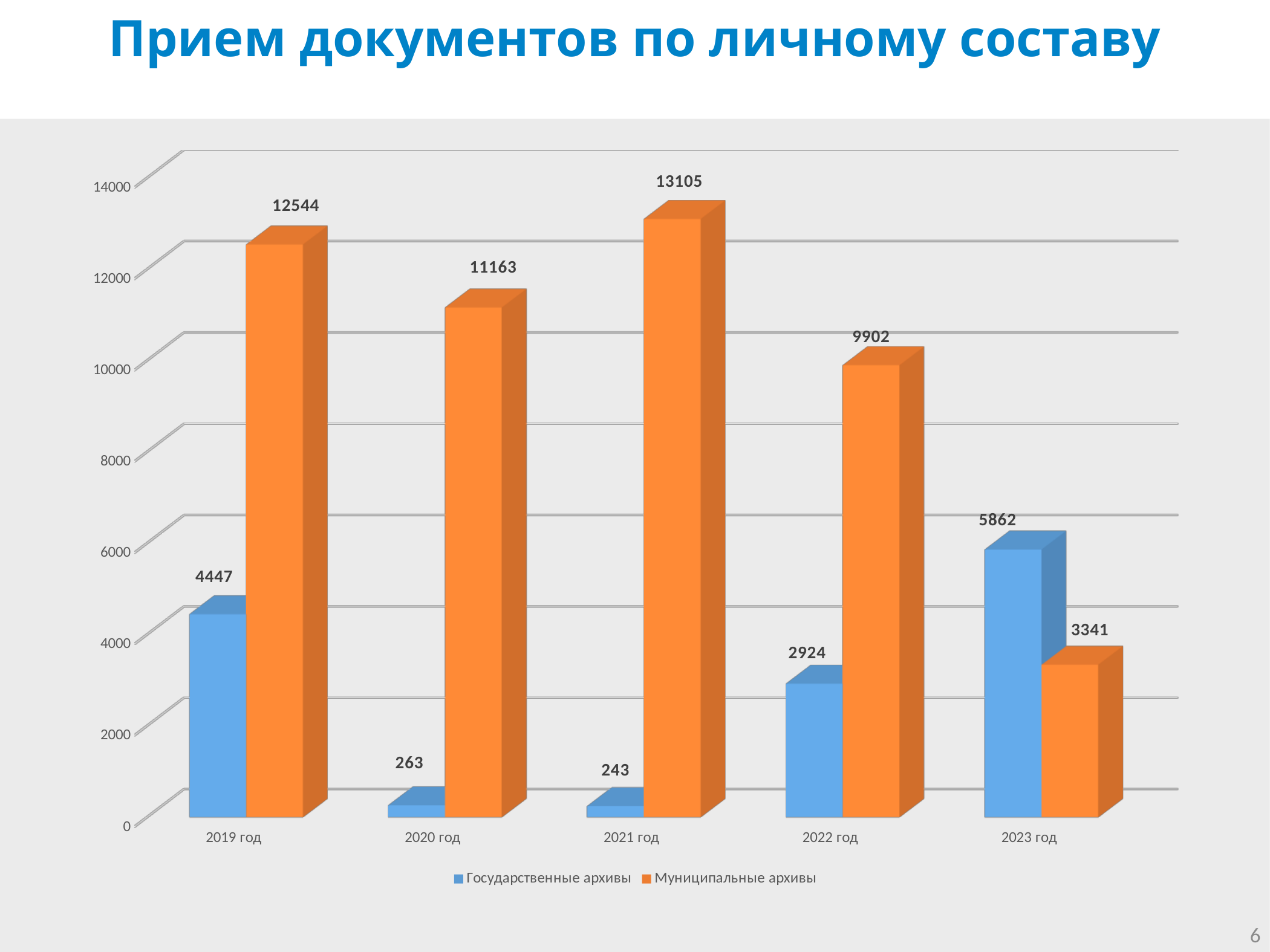
How many years are shown on the x axis? 5 What is the value for Муниципальные архивы in 2021 год? 13105 Is the value for Муниципальные архивы in 2020 год greater or less than 10000? greater What is the title of the slide? Прием документов по личному составу How many series does the legend list? 2 In which year is the value for Государственные архивы lowest? 2021 год Which series has the larger value in 2023 год, Государственные архивы or Муниципальные архивы? Государственные архивы What is the value for Муниципальные архивы in 2023 год? 3341 What is the difference between Муниципальные архивы and Государственные архивы in 2022 год? 6978 What kind of chart is shown on the slide? bar chart In which year is the value for Муниципальные архивы highest? 2021 год What is the value for Государственные архивы in 2019 год? 4447